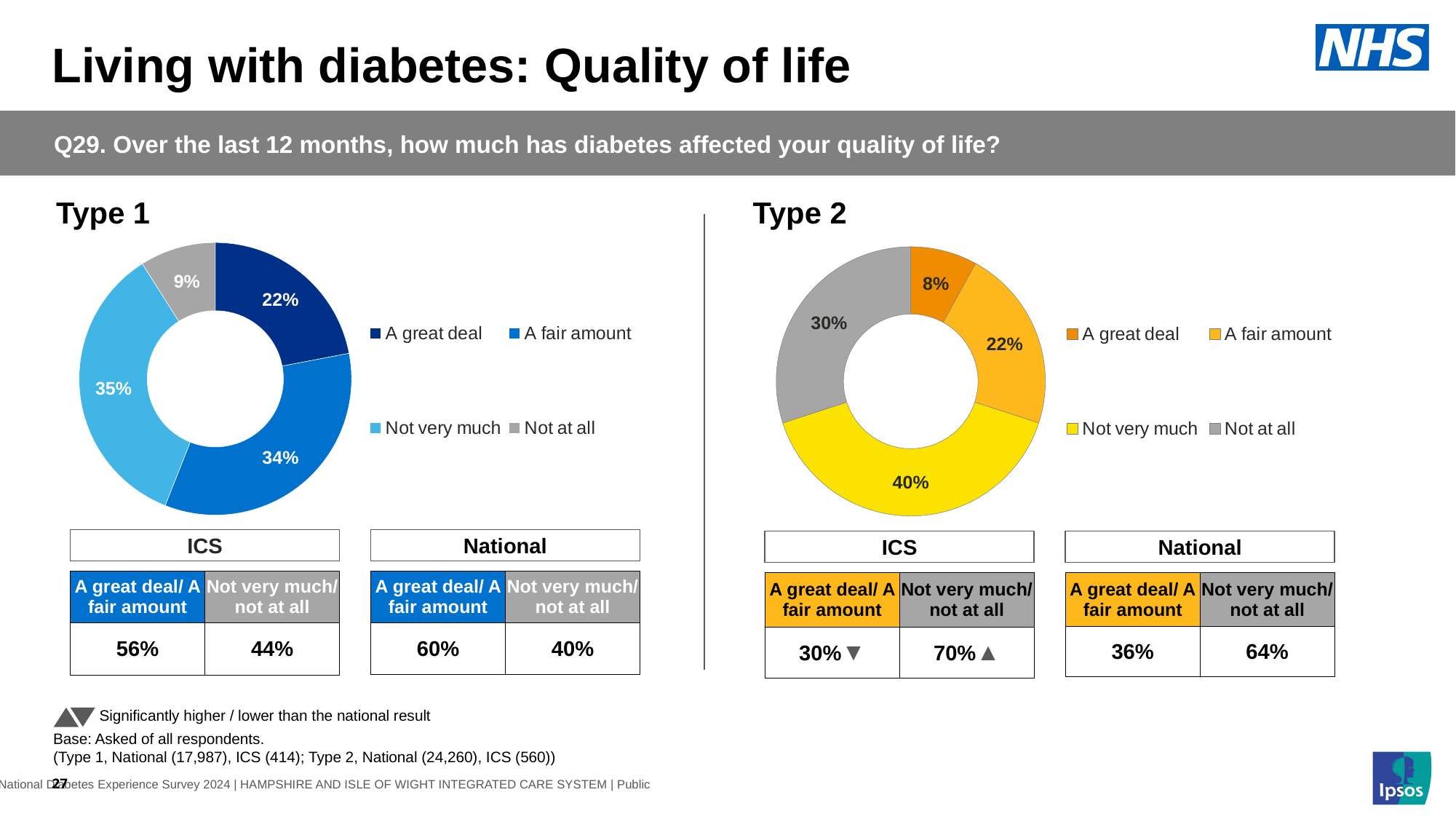
In the Type 2 chart, what percentage of respondents said 'A great deal'? 8% In the Type 1 chart, what colour is the 'A fair amount' segment? Blue In the Type 1 chart, what is the difference between the 'Not very much' share and the 'Not at all' share? 26% In the Type 2 chart, what percentage of respondents said 'Not at all'? 30% In the Type 2 chart, is the share for 'Not very much' larger or smaller than the share for 'Not at all'? larger In the Type 1 chart, what percentage of respondents said 'Not very much'? 35% How many categories does the Type 1 chart show? 4 In the Type 1 chart, what percentage of respondents said 'A great deal'? 22% In the Type 1 chart, which category has the smallest share? Not at all In the Type 2 chart, which category has the largest share? Not very much What kind of chart is used for Type 2? Doughnut chart In the Type 2 chart, which category has the smallest share? A great deal